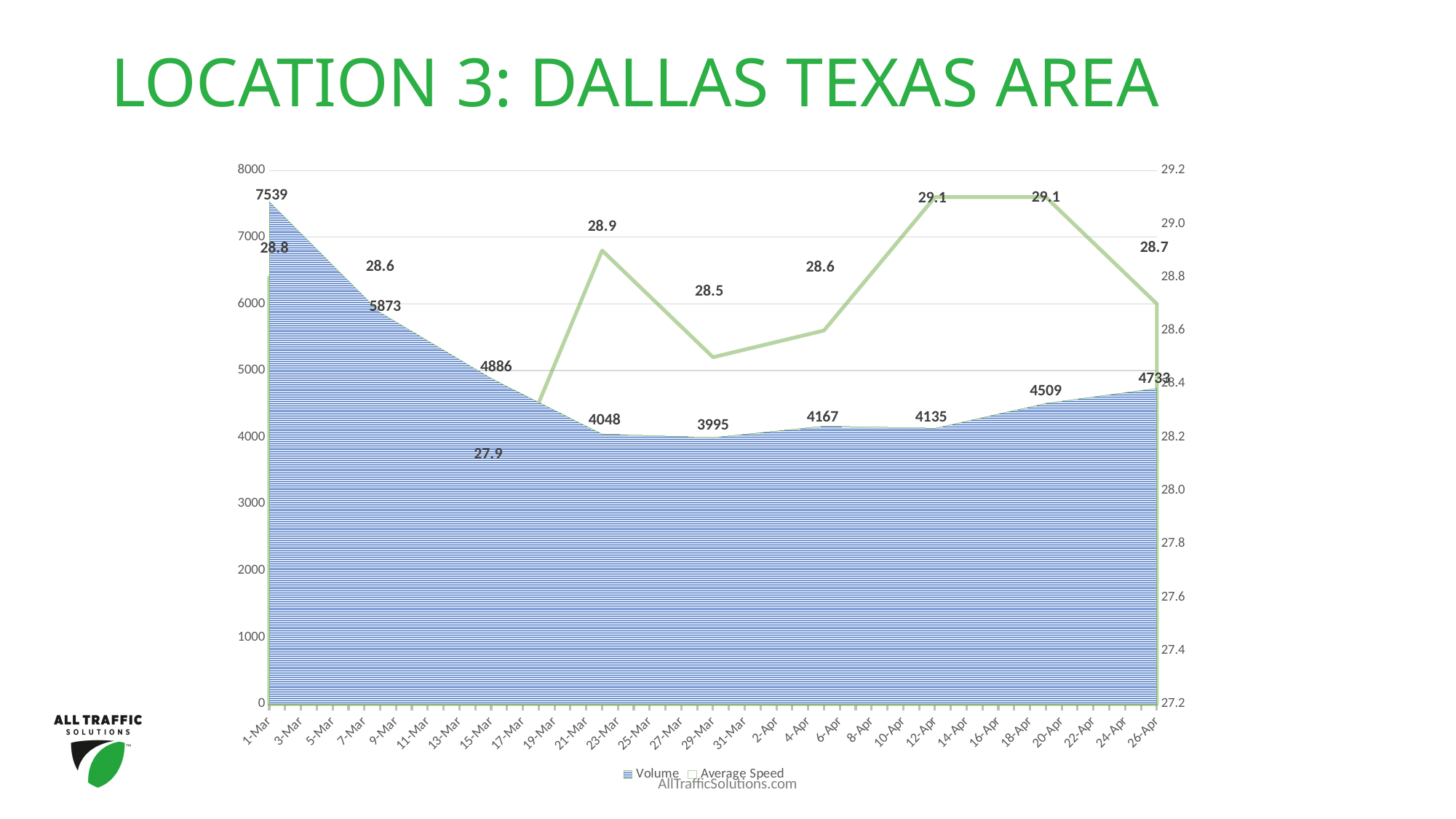
How many series does the legend list? 2 What kind of chart is shown on the slide? area and line chart What is the Volume value on 26-Apr? 4733 What is the difference between the Volume on 1-Mar (7539) and the Volume on 26-Apr (4733)? 2806 What are the two series named in the legend? Volume and Average Speed What is the lowest Volume value labelled on the chart? 3995 What is the highest Volume value labelled on the chart? 7539 What is the lowest Average Speed value labelled on the chart? 27.9 What is the highest Average Speed value labelled on the chart? 29.1 Does the Volume rise or fall from 1-Mar to 29-Mar? fall What is the Volume value on 1-Mar? 7539 What is the Average Speed value on 26-Apr? 28.7